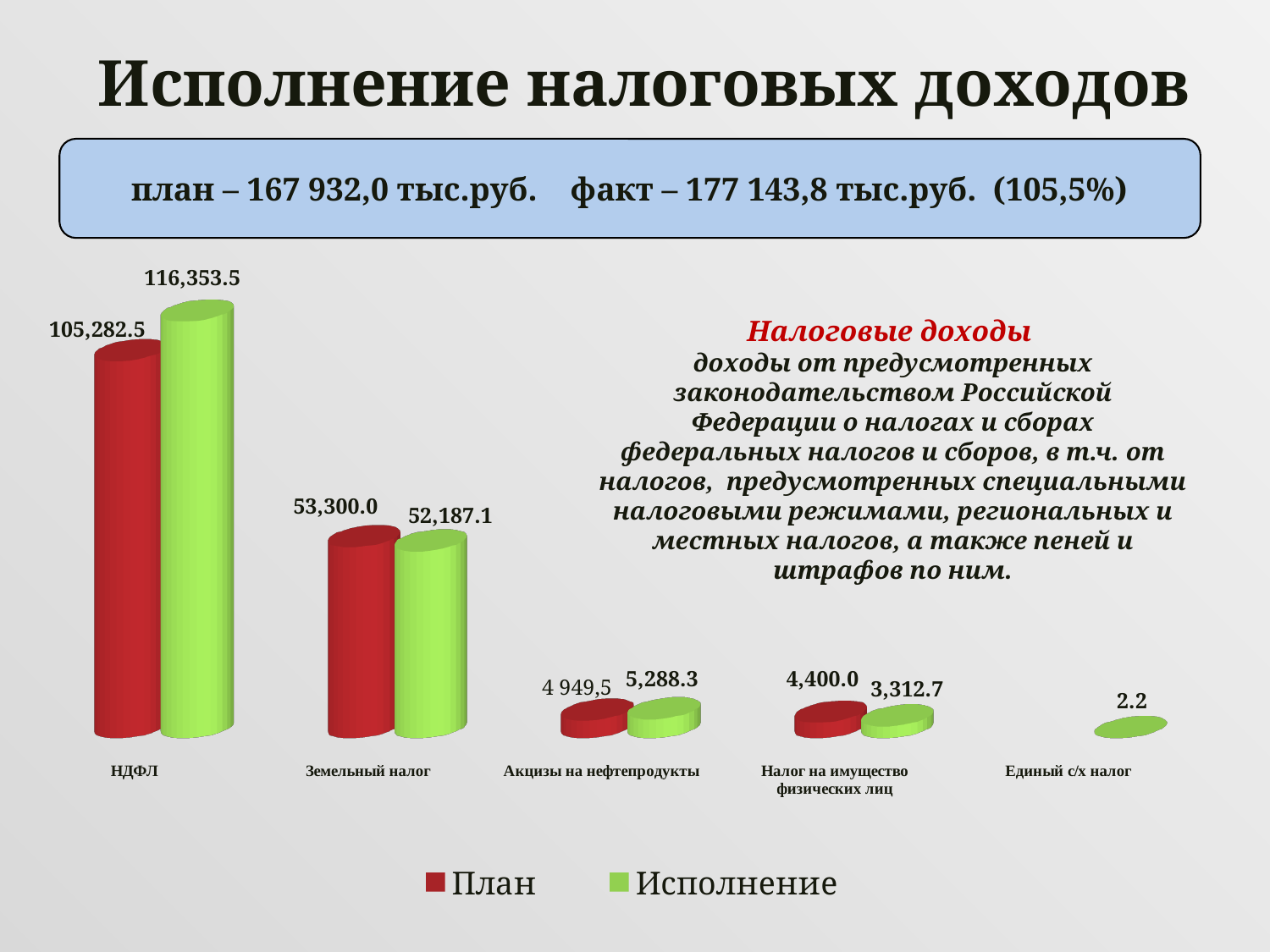
What is the difference between the Исполнение and План values for НДФЛ? 11,071.0 How many series does the legend list? 2 Which category has the lowest Исполнение value? Единый с/х налог Which category has the highest Исполнение value? НДФЛ For Земельный налог, which is larger: План or Исполнение? План What is the План value for Налог на имущество физических лиц? 4,400.0 What is the План value for НДФЛ? 105,282.5 What is the Исполнение value for Земельный налог? 52,187.1 What is the Исполнение value for НДФЛ? 116,353.5 What is the Исполнение value for Единый с/х налог? 2.2 How many categories are shown on the x axis of the chart? 5 What kind of chart is shown on the slide? Bar chart